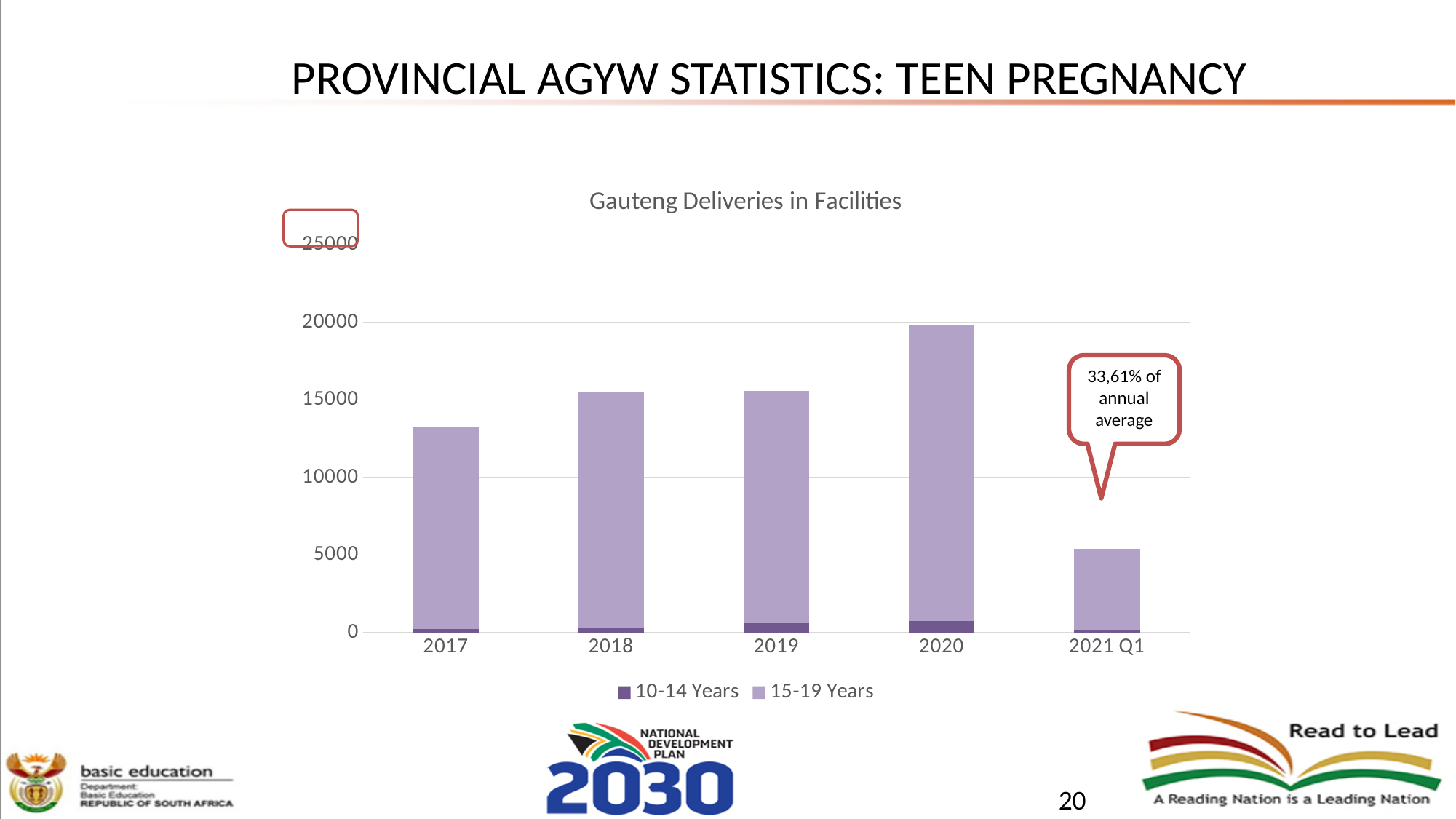
Is the total for 2017 greater or less than 15000? less How many categories are shown on the x axis? 5 Which is larger, the total for 2020 or the total for 2017? 2020 What kind of chart is shown on the slide? bar chart Which year has the highest total deliveries in facilities? 2020 Which series is shown in the darker purple colour? 10-14 Years What is the title of the chart? Gauteng Deliveries in Facilities Is the total for 2019 greater or less than 10000? greater Is the total for 2020 greater or less than 15000? greater How many series does the legend list? 2 Which category has the lowest total deliveries in facilities? 2021 Q1